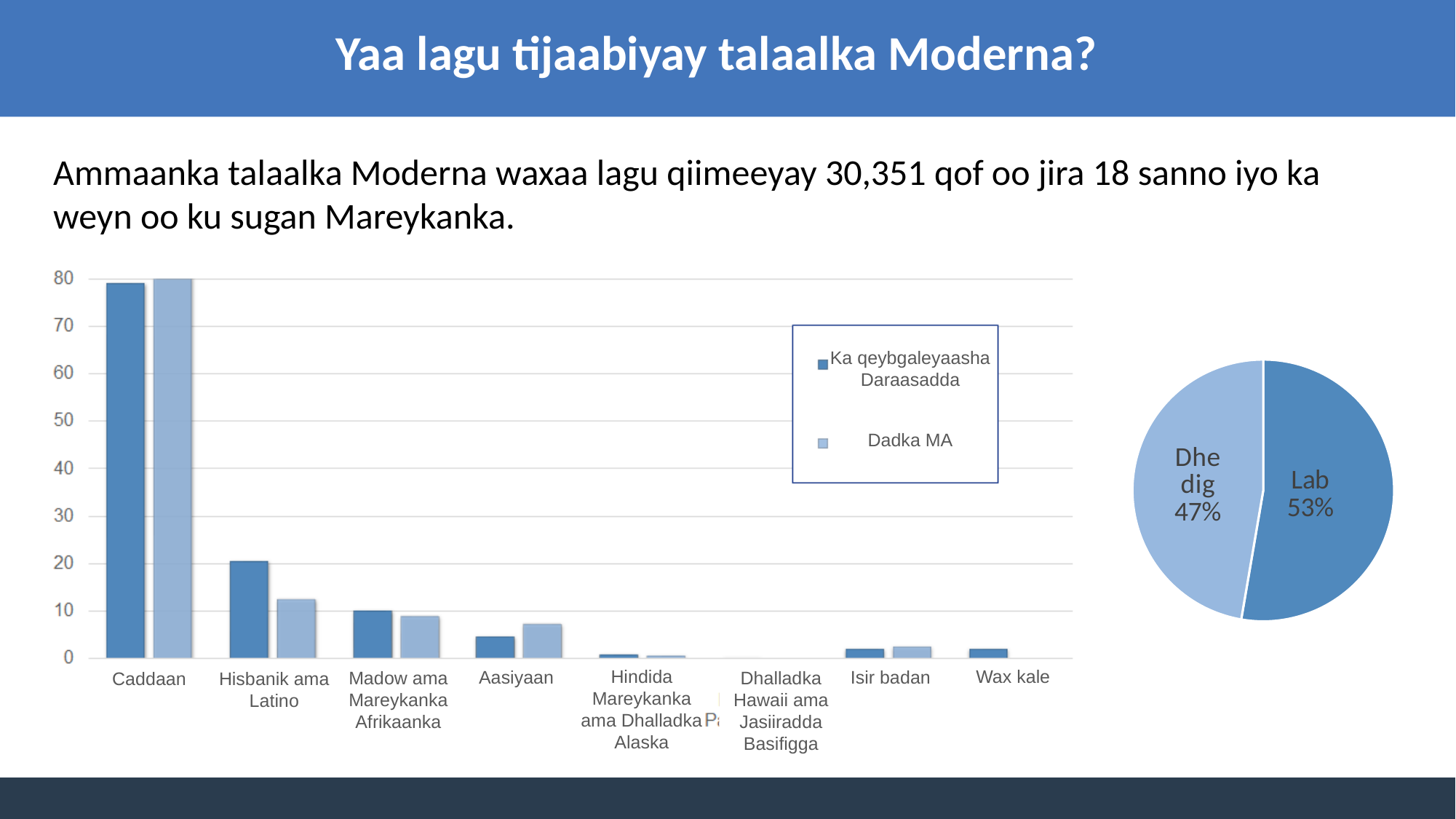
In the pie chart on the right, what share does Dhedig have? 47% In the bar chart on the left, is the Dadka MA value for Hisbanik ama Latino greater or less than 10? greater In the bar chart on the left, for Hisbanik ama Latino, which series has the larger value: Ka qeybgaleyaasha Daraasadda or Dadka MA? Ka qeybgaleyaasha Daraasadda What kind of chart is the chart on the left of the slide? bar chart In the bar chart on the left, is the Ka qeybgaleyaasha Daraasadda value for Hisbanik ama Latino greater or less than 30? less In the bar chart on the left, which category has the highest values? Caddaan In the bar chart on the left, how many categories are shown on the x axis? 8 In the pie chart on the right, what share does Lab have? 53% What kind of chart is the chart on the right of the slide? pie chart In the pie chart on the right, which slice is larger: Lab or Dhedig? Lab In the bar chart on the left, how many series does the legend list? 2 In the bar chart on the left, is the Ka qeybgaleyaasha Daraasadda value for Caddaan greater or less than 70? greater